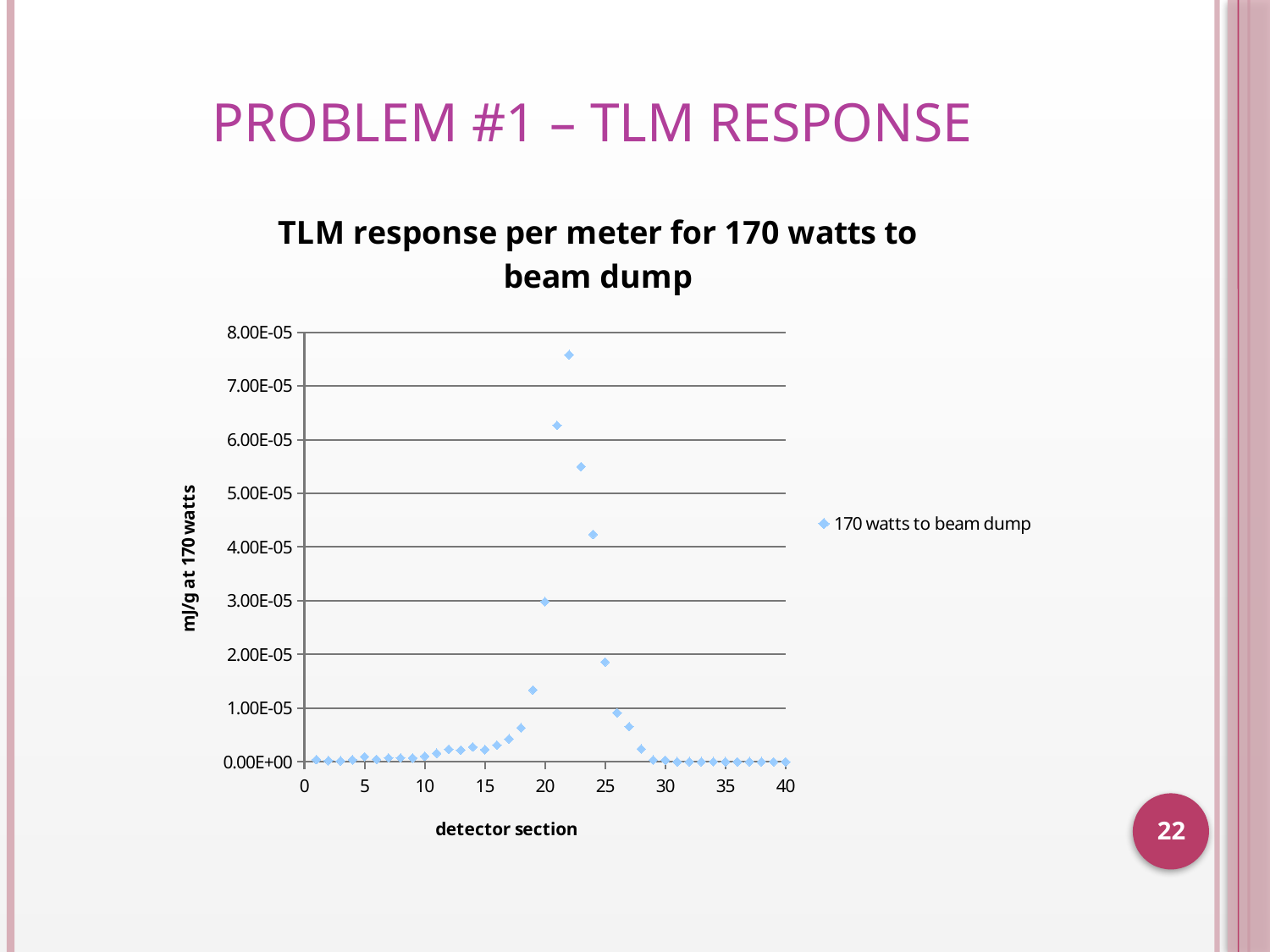
Do the values rise or fall from detector section 22 to detector section 30? fall Which has the larger value, detector section 21 or detector section 23? detector section 21 Is the value at detector section 22 greater or less than 7.00E-05? greater Is the value at detector section 20 greater or less than 4.00E-05? less What kind of chart is shown on the slide? scatter chart How many series does the legend list? 1 Is the value at detector section 24 greater or less than 3.00E-05? greater What is the title of the chart? TLM response per meter for 170 watts to beam dump Which has the larger value, detector section 20 or detector section 24? detector section 24 At which detector section is the TLM response highest? 22 What is the label of the x axis? detector section